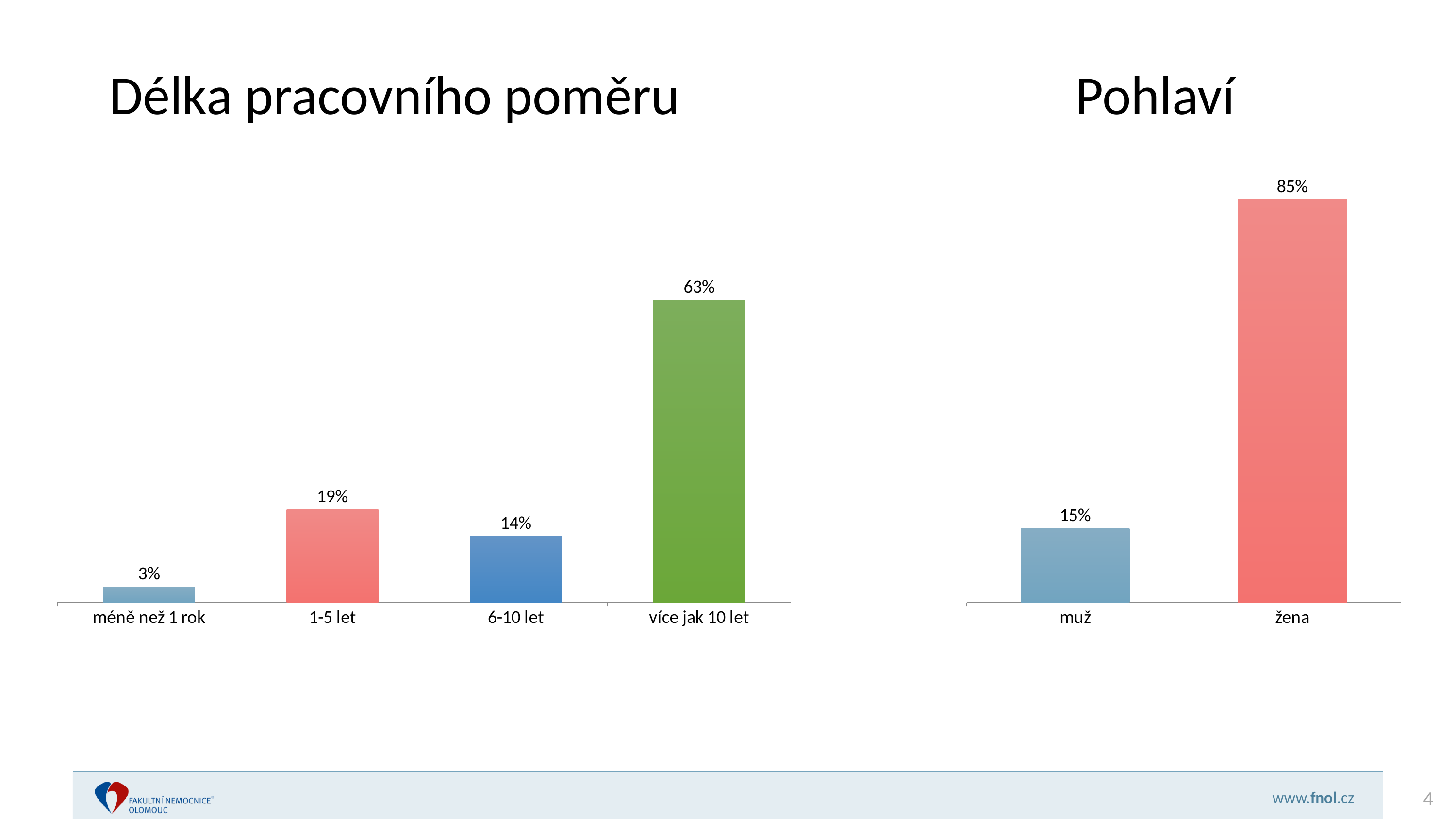
In the 'Délka pracovního poměru' chart, which category has the lowest value? méně než 1 rok In the 'Délka pracovního poměru' chart, what is the value for 'méně než 1 rok'? 3% In the 'Délka pracovního poměru' chart, what is the difference between the values for '1-5 let' and '6-10 let'? 5% In the 'Délka pracovního poměru' chart, which is larger, the value for '1-5 let' or '6-10 let'? 1-5 let In the 'Délka pracovního poměru' chart, what is the value for 'více jak 10 let'? 63% In the 'Pohlaví' chart, what is the value for 'muž'? 15% In the 'Délka pracovního poměru' chart, which category has the highest value? více jak 10 let What kind of chart is the 'Pohlaví' chart? bar chart How many categories are shown in the 'Pohlaví' chart? 2 How many categories are shown in the 'Délka pracovního poměru' chart? 4 In the 'Pohlaví' chart, what is the difference between the values for 'žena' and 'muž'? 70% In the 'Pohlaví' chart, what is the value for 'žena'? 85%